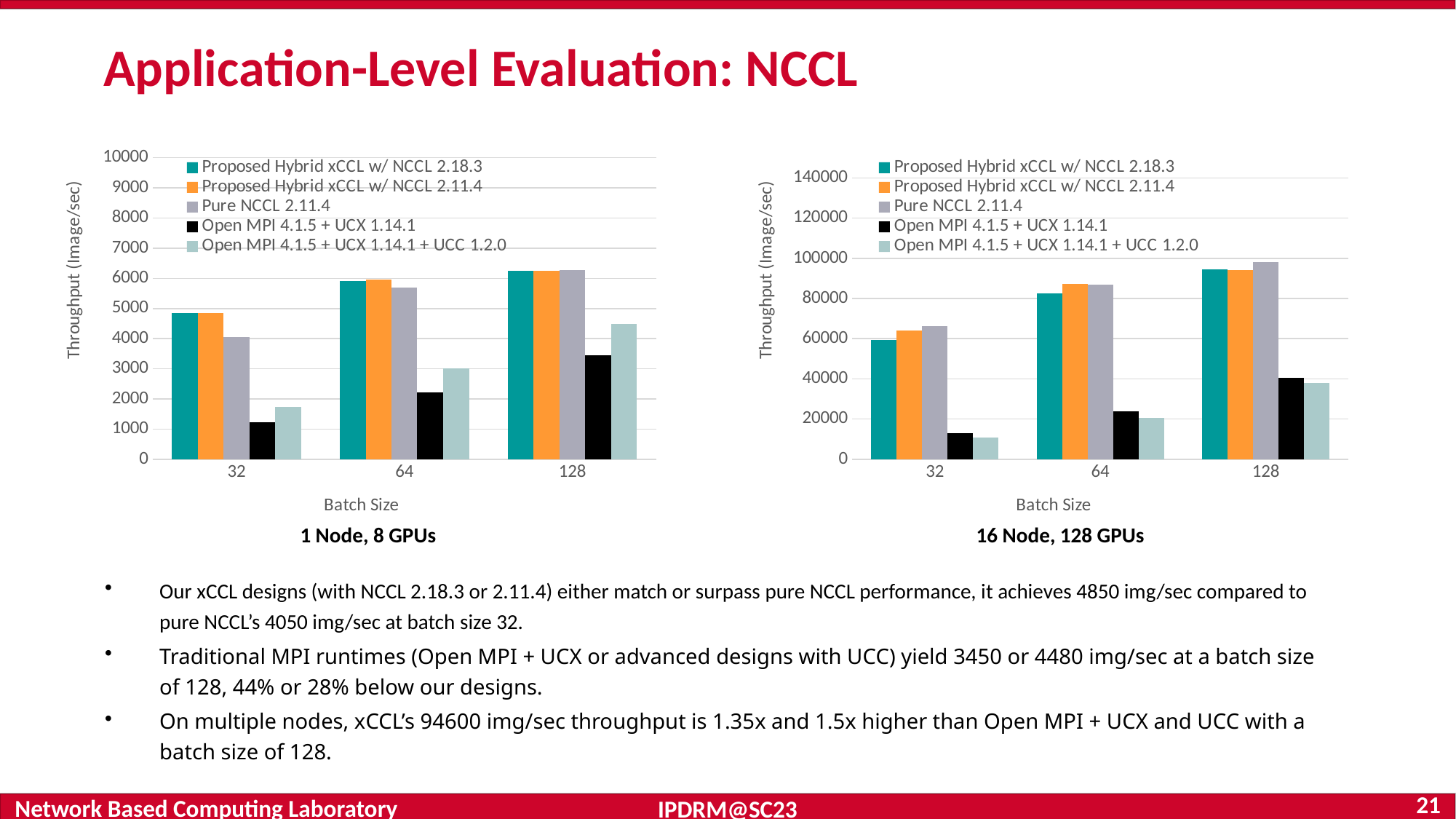
In the "1 Node, 8 GPUs" chart, is the value for Open MPI 4.1.5 + UCX 1.14.1 at batch size 32 greater or less than 2000? less In the "1 Node, 8 GPUs" chart, which series has the lowest throughput at batch size 32? Open MPI 4.1.5 + UCX 1.14.1 How many batch sizes are shown on the x axis of the "1 Node, 8 GPUs" chart? 3 In the "16 Node, 128 GPUs" chart, is the value for Pure NCCL 2.11.4 at batch size 128 greater or less than 80000? greater What kind of chart is the "1 Node, 8 GPUs" chart? bar chart In the "16 Node, 128 GPUs" chart, is the value for Open MPI 4.1.5 + UCX 1.14.1 + UCC 1.2.0 at batch size 32 greater or less than 20000? less In the "16 Node, 128 GPUs" chart, at batch size 64, which is larger: Open MPI 4.1.5 + UCX 1.14.1 or Open MPI 4.1.5 + UCX 1.14.1 + UCC 1.2.0? Open MPI 4.1.5 + UCX 1.14.1 How many series does the legend of the "16 Node, 128 GPUs" chart list? 5 What is the y-axis label of the "1 Node, 8 GPUs" chart? Throughput (Image/sec) In the "1 Node, 8 GPUs" chart, does the throughput of Open MPI 4.1.5 + UCX 1.14.1 + UCC 1.2.0 rise or fall as batch size increases from 32 to 128? rise In the "16 Node, 128 GPUs" chart, which series has the highest throughput at batch size 128? Pure NCCL 2.11.4